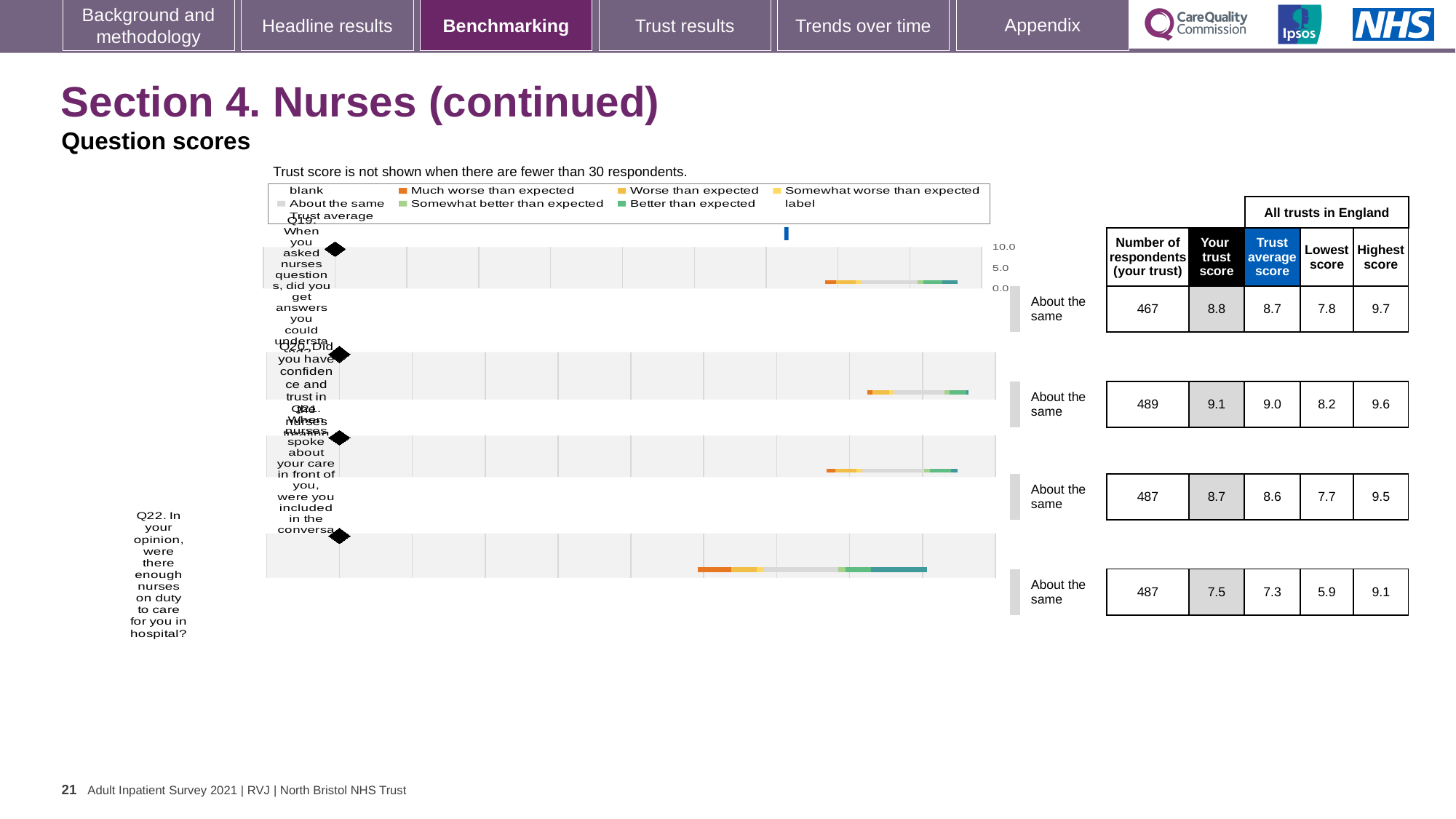
Which question has the lowest 'Your trust score'? Q22 What is the 'Your trust score' for Q22 (were there enough nurses on duty)? 7.5 How many questions (rows) are plotted in the chart? 4 What kind of chart is shown on the slide? bar chart What is the highest score across all trusts in England for Q21? 9.5 Which is larger, the 'Your trust score' for Q20 or for Q21? Q20 Is the 'Your trust score' for Q22 greater or less than 5.0? greater What is the difference between the highest score and the lowest score for Q22? 3.2 What benchmark category is shown for all four questions? About the same What is the trust average score for Q19? 8.7 How many respondents from your trust answered Q20? 489 Which question has the highest 'Your trust score'? Q20